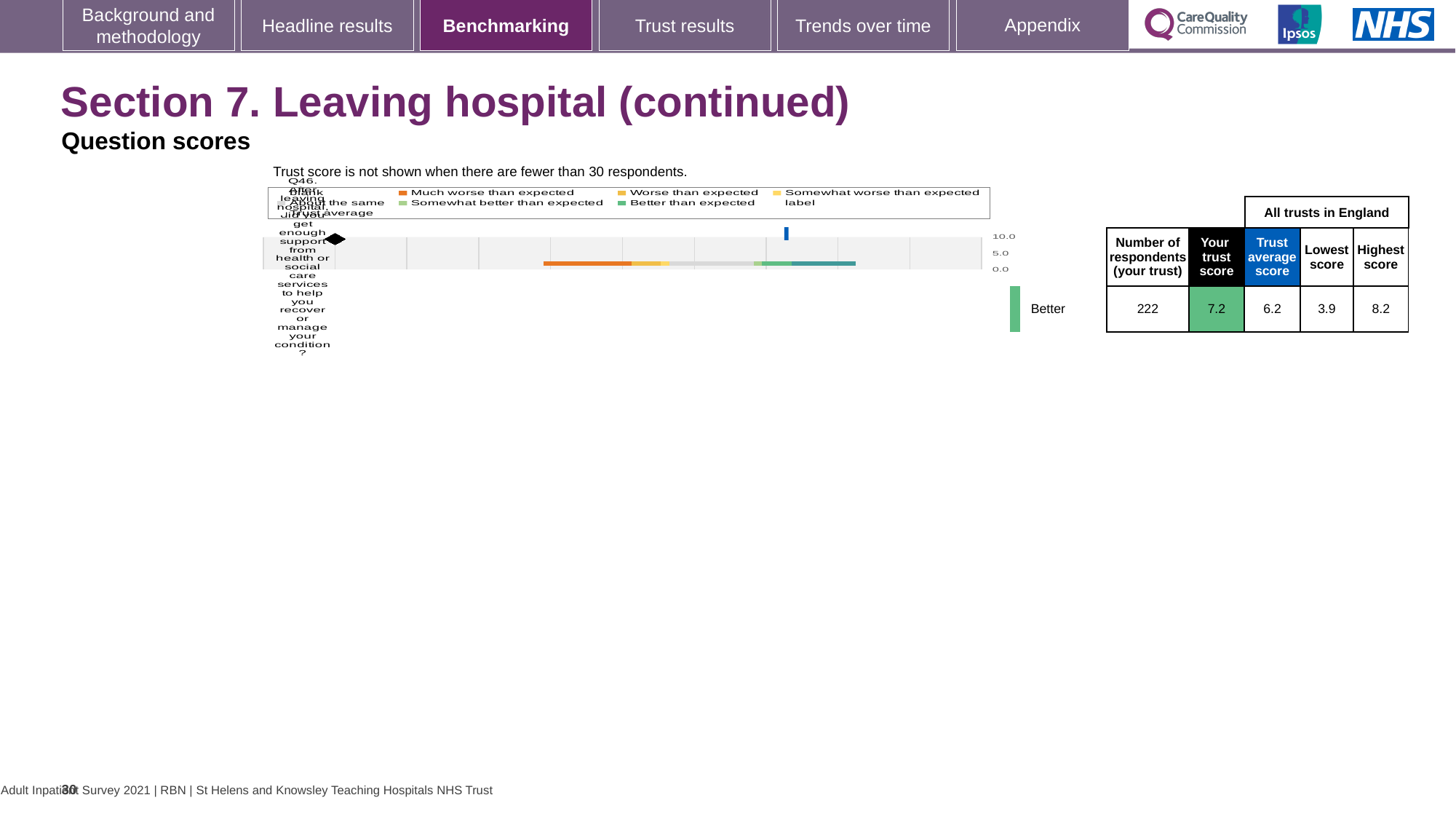
How many questions are plotted in the chart? 1 What is the difference between the trust's score and the trust average score for Q46? 1.0 What is the lowest score among all trusts in England for Q46? 3.9 What benchmark category label is shown to the right of the chart for Q46? Better Is the trust's score for Q46 greater or less than 5.0 on the chart axis? greater Which is larger for Q46: the trust's score or the trust average score? the trust's score What is the trust score for Q46 shown in the table next to the chart? 7.2 What is the trust average score for Q46 across all trusts in England? 6.2 What is the difference between the highest and lowest scores among all trusts in England for Q46? 4.3 What kind of chart is shown on the slide? bar chart What is the highest score among all trusts in England for Q46? 8.2 How many respondents from the trust answered Q46? 222